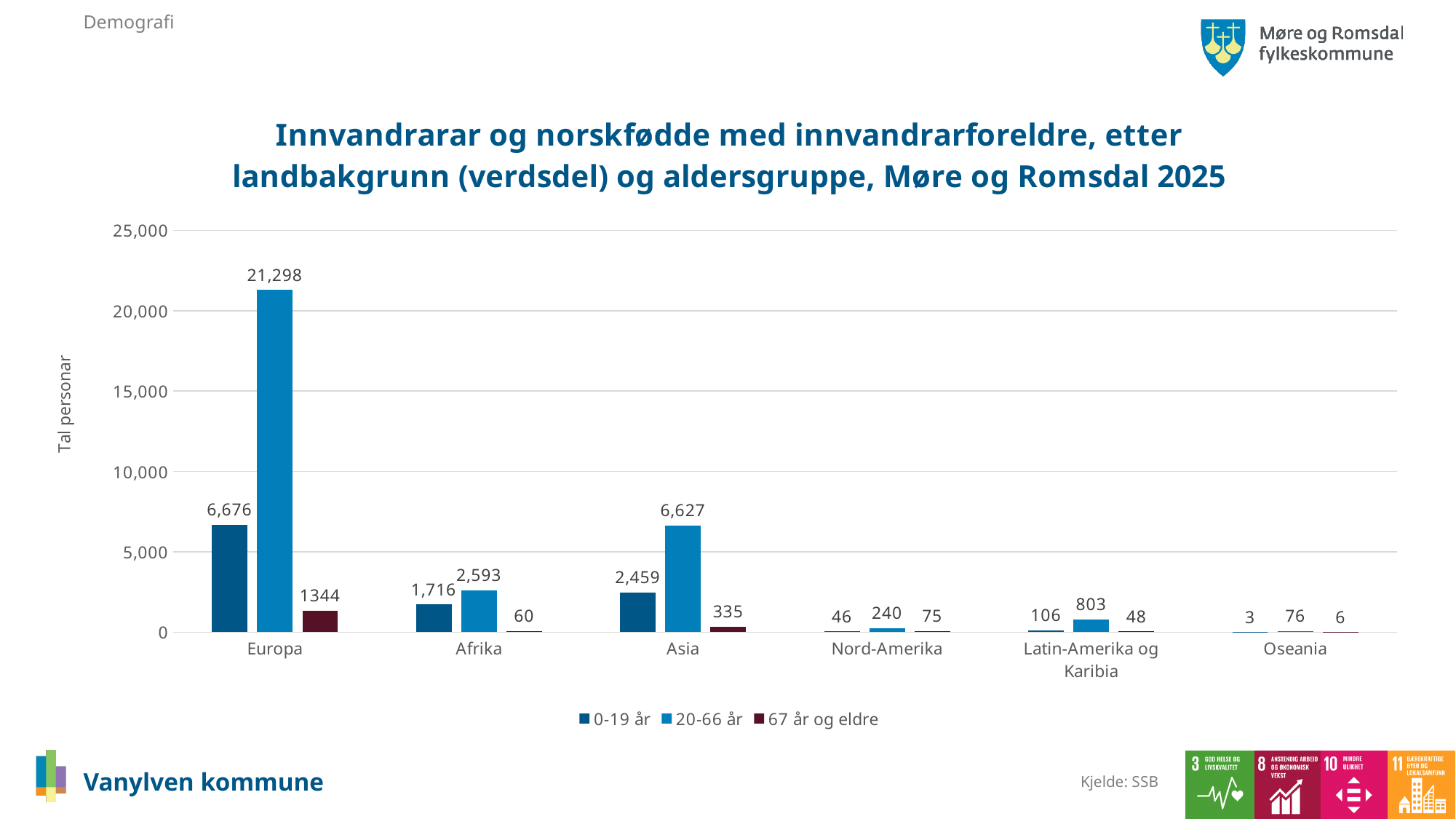
What kind of chart is shown on the slide? Bar chart How many series does the legend list? 3 What is the value for the 0-19 år series for Asia? 2,459 What is the label of the y axis? Tal personar Which category has the highest value in the 20-66 år series? Europa What is the value for the 67 år og eldre series for Afrika? 60 What is the difference between the 20-66 år values for Asia and Afrika? 4,034 What is the value for the 20-66 år series for Latin-Amerika og Karibia? 803 What is the value for the 20-66 år series for Europa? 21,298 Which category has the lowest value in the 0-19 år series? Oseania Which is larger: the 0-19 år value for Europa or the 20-66 år value for Asia? 0-19 år value for Europa How many categories are shown on the x axis? 6